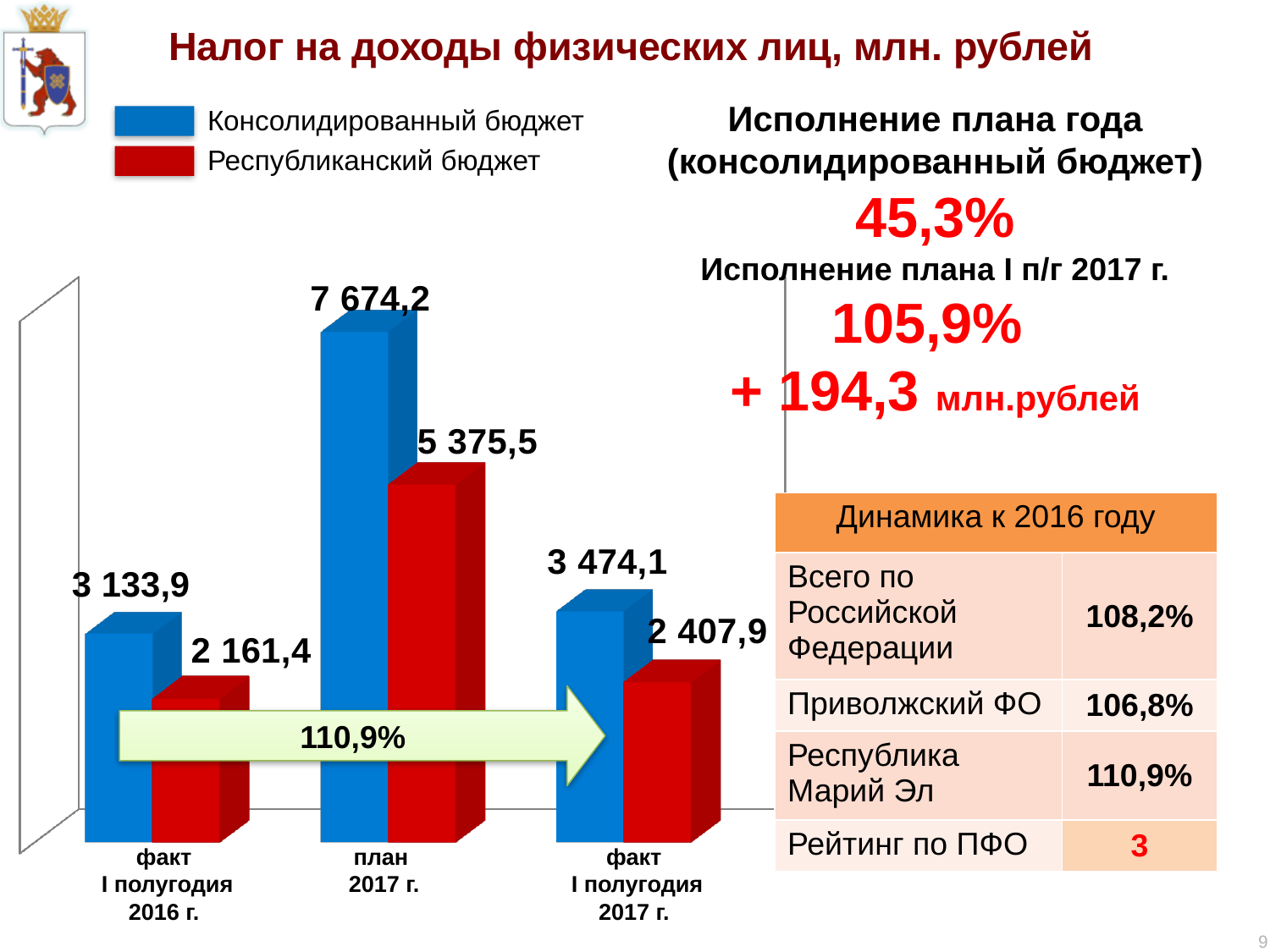
What is the value of Консолидированный бюджет for план 2017 г.? 7 674,2 What is the difference between Консолидированный бюджет and Республиканский бюджет for план 2017 г.? 2 298,7 Which is larger: Республиканский бюджет for факт I полугодия 2017 г. or for факт I полугодия 2016 г.? факт I полугодия 2017 г. Which category has the lowest value for Республиканский бюджет? факт I полугодия 2016 г. What is the value of Консолидированный бюджет for факт I полугодия 2017 г.? 3 474,1 What type of chart is shown on the slide? bar chart How many categories are shown on the x axis of the chart? 3 What is the value of Республиканский бюджет for факт I полугодия 2016 г.? 2 161,4 Which category has the highest value for Консолидированный бюджет? план 2017 г. How many series does the legend list? 2 What is the value of Республиканский бюджет for факт I полугодия 2017 г.? 2 407,9 What is the difference between Консолидированный бюджет for факт I полугодия 2017 г. and факт I полугодия 2016 г.? 340,2